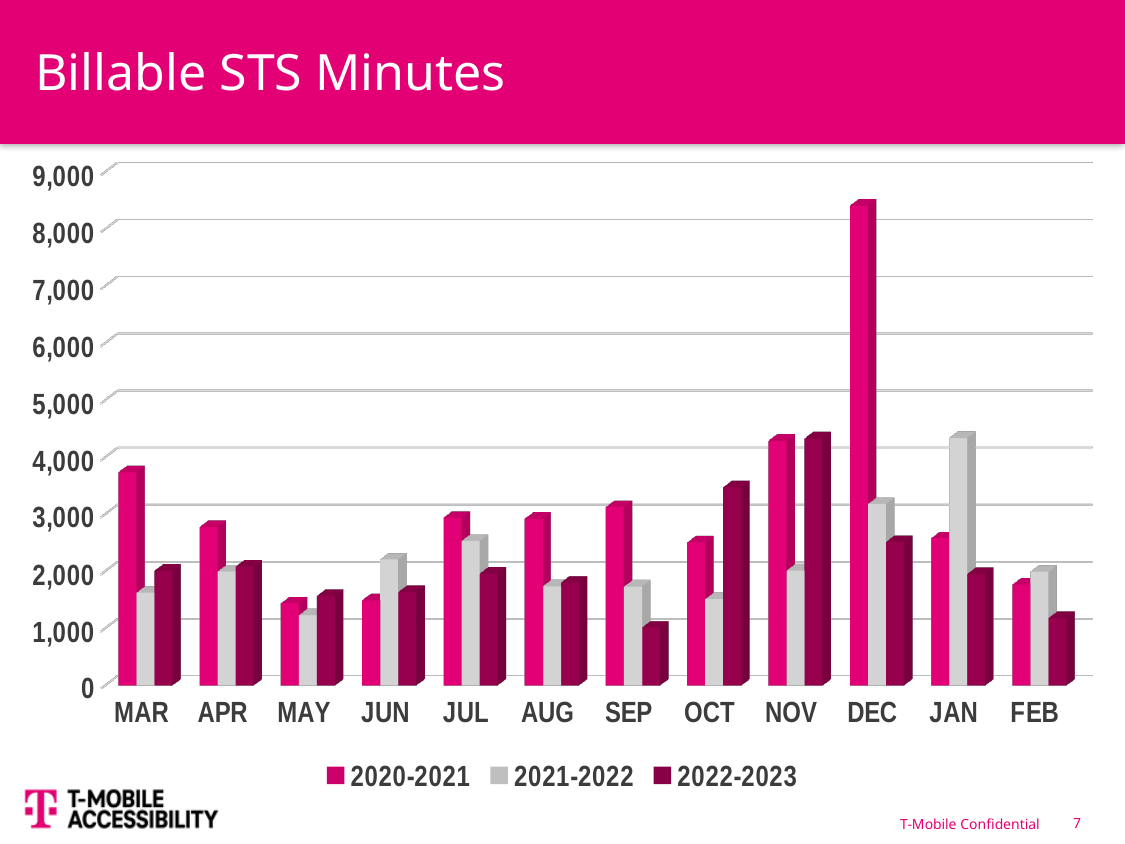
How many months are shown on the x axis? 12 Which month has the highest value for the 2022-2023 series? NOV Is the 2021-2022 value for JAN greater or less than 4,000? greater How many series does the legend list? 3 Which month has the highest value for the 2021-2022 series? JAN Is the 2020-2021 value for DEC greater or less than 8,000? greater Which month has the lowest value for the 2022-2023 series? SEP What is the title of the chart? Billable STS Minutes Which month has the highest value for the 2020-2021 series? DEC What kind of chart is shown on the slide? bar chart In OCT, which series has the larger value: 2020-2021 or 2022-2023? 2022-2023 Is the 2022-2023 value for FEB greater or less than 1,500? less